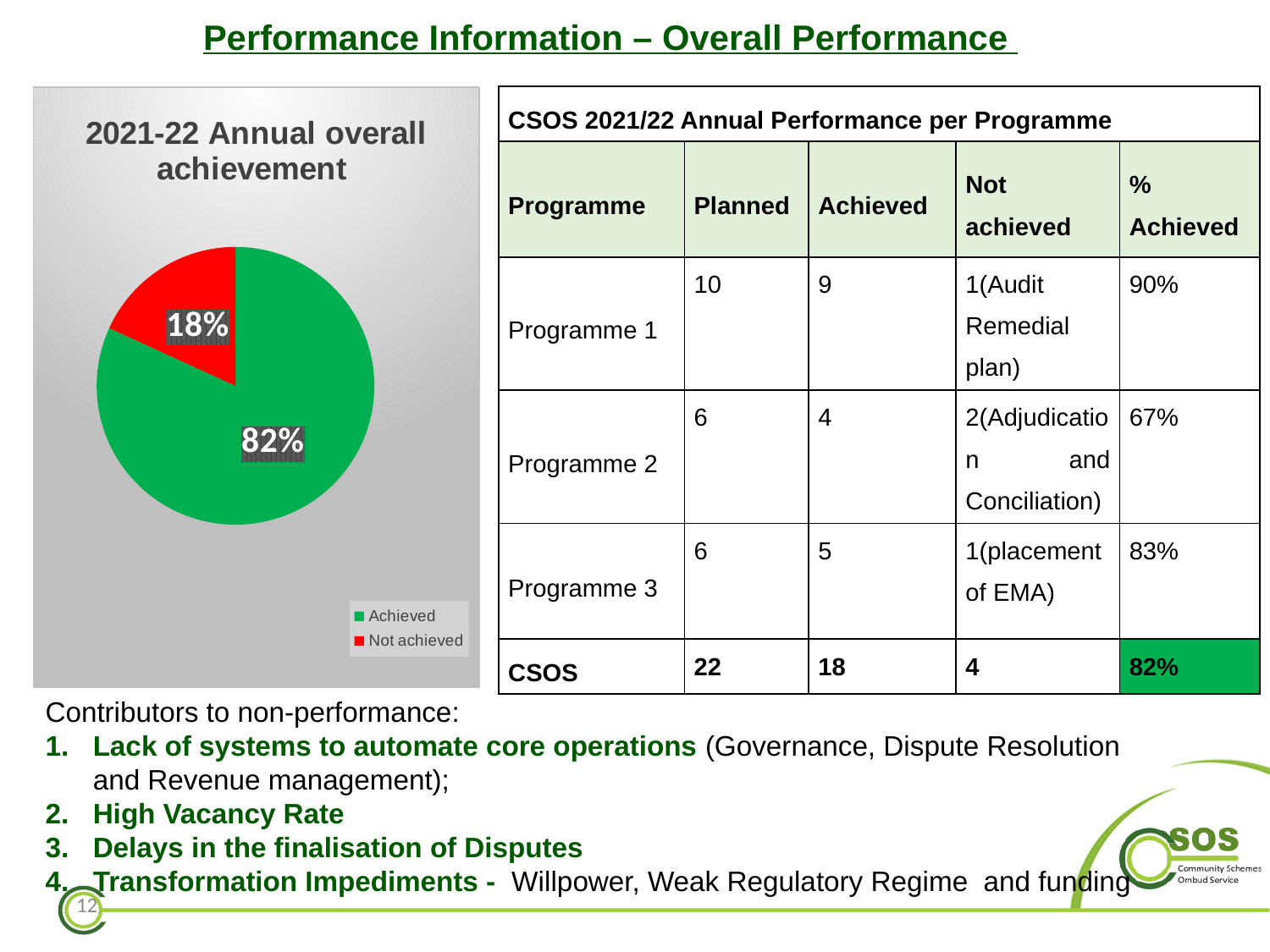
What percentage of the pie chart is labelled Not achieved? 18% Which slice of the pie chart is the smallest? Not achieved Which slice of the pie chart is the largest? Achieved How many entries does the pie chart legend list? 2 What type of chart is shown on the slide? Pie chart What colour is the Not achieved slice in the pie chart? Red What is the difference in percentage points between the Achieved and Not achieved slices? 64 What percentage of the pie chart is labelled Achieved? 82% What is the title of the pie chart? 2021-22 Annual overall achievement Which is larger in the pie chart, Achieved or Not achieved? Achieved What share of the pie does the Achieved slice represent? 82% How many slices does the pie chart have? 2